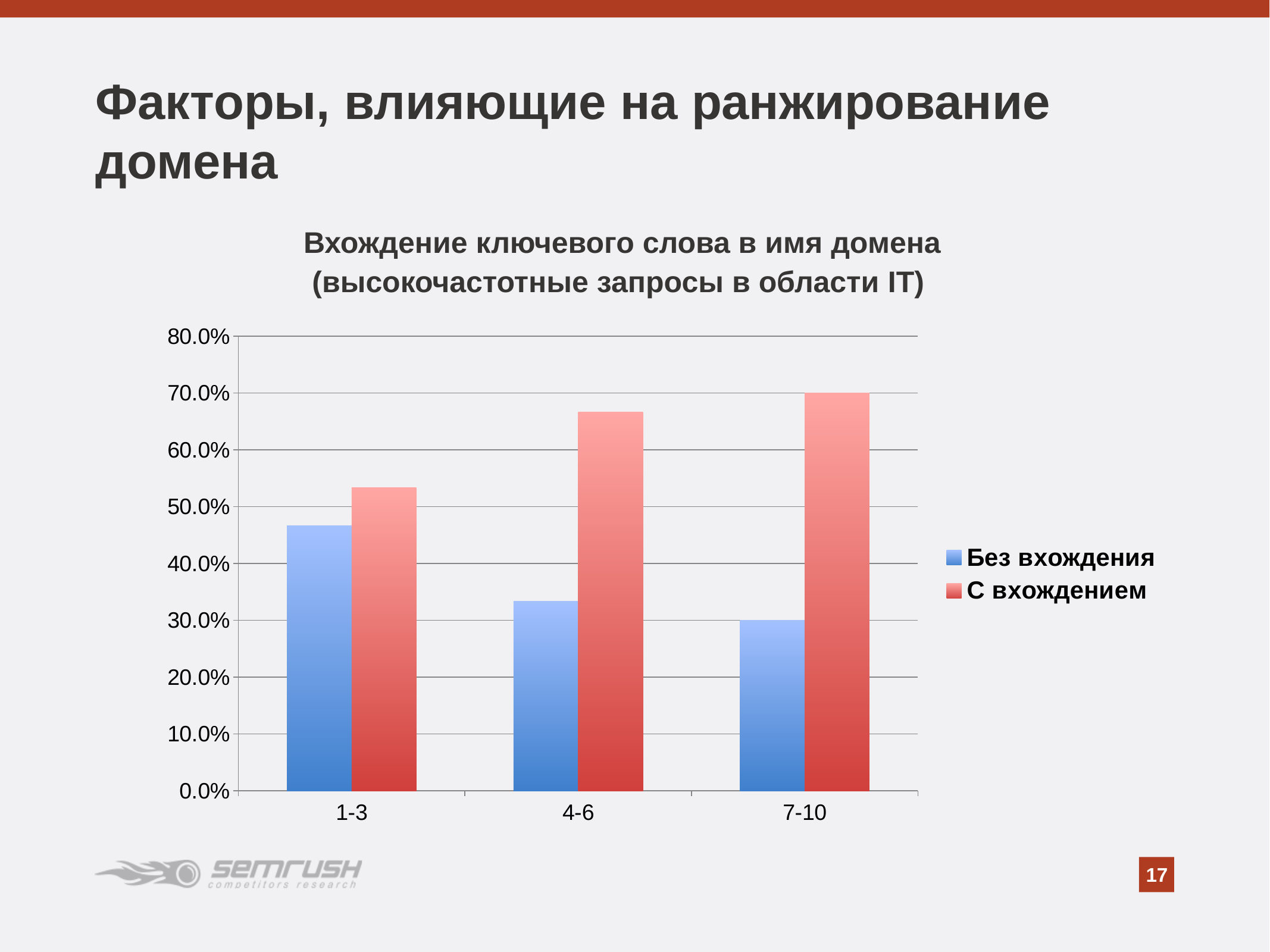
How many series does the chart's legend list? 2 Which category has the lowest value for the series "Без вхождения"? 7-10 Which category has the highest value for the series "Без вхождения"? 1-3 Which category has the highest value for the series "С вхождением"? 7-10 Is the value for "Без вхождения" in category 1-3 greater or less than 40.0%? greater What kind of chart is shown on the slide? bar chart Is the value for "С вхождением" in category 4-6 greater or less than 60.0%? greater For the category 4-6, which series has the larger value: "Без вхождения" or "С вхождением"? С вхождением Is the value for "Без вхождения" in category 7-10 greater or less than 40.0%? less Which colour represents the series "С вхождением" in the chart? red How many categories are shown on the x axis of the chart? 3 Do the values for the series "Без вхождения" rise or fall from category 1-3 to category 7-10? fall